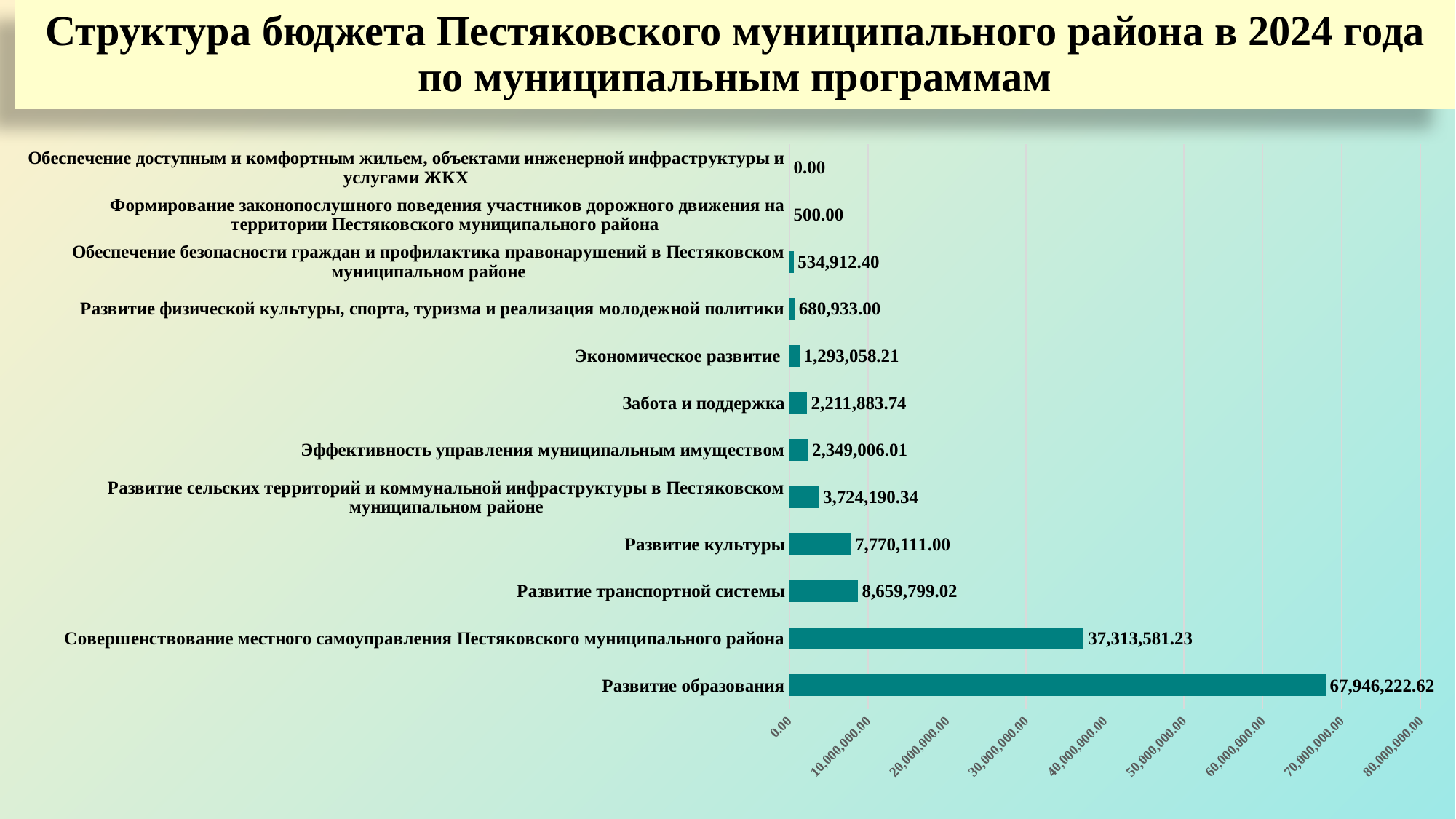
What is the value for Развитие культуры? 7,770,111.00 Is the value for Развитие образования greater or less than 60,000,000.00? greater What is the value for Забота и поддержка? 2,211,883.74 What is the value for Развитие образования? 67,946,222.62 What type of chart is shown on the slide? Bar chart How many categories (municipal programmes) are plotted in the chart? 12 Which is larger: the value for Развитие транспортной системы or the value for Развитие культуры? Развитие транспортной системы What is the difference between the values for Развитие образования and Совершенствование местного самоуправления Пестяковского муниципального района? 30,632,641.39 Which programme has the lowest value in the chart? Обеспечение доступным и комфортным жильем, объектами инженерной инфраструктуры и услугами ЖКХ What is the value for Совершенствование местного самоуправления Пестяковского муниципального района? 37,313,581.23 Which programme has the highest value in the chart? Развитие образования What is the difference between the values for Развитие транспортной системы and Развитие культуры? 889,688.02